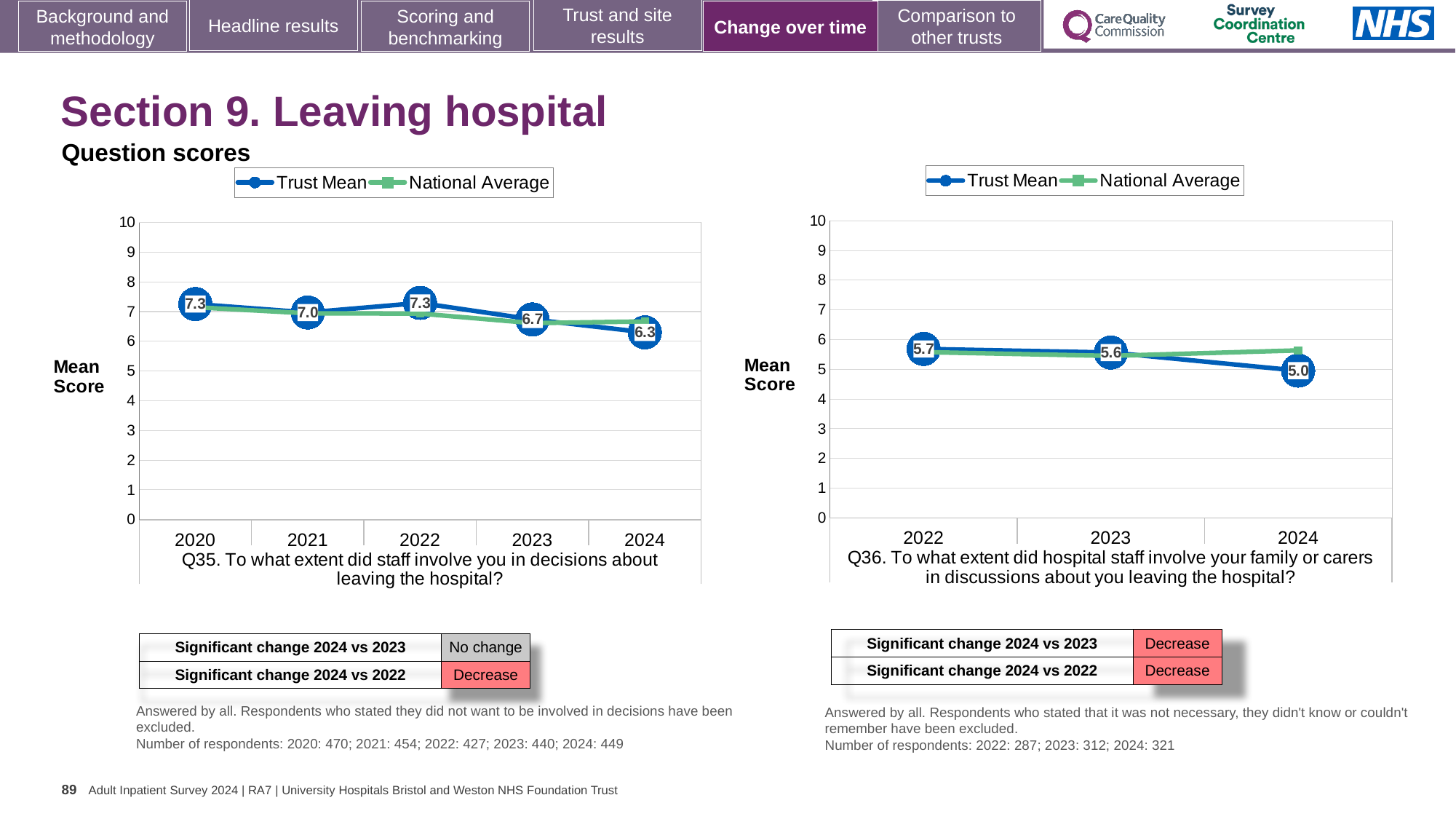
How many years are plotted on the x axis of the Q35 chart (left)? 5 In the Q36 chart (right), which year has the highest Trust Mean score? 2022 In the Q36 chart (right), what is the Trust Mean score for 2024? 5.0 In the Q35 chart (left), is the Trust Mean score for 2023 higher or lower than for 2024? higher In the Q35 chart (left), what is the Trust Mean score for 2024? 6.3 In the Q36 chart (right), what is the difference between the Trust Mean scores for 2022 and 2024? 0.7 In the Q35 chart (left), what is the Trust Mean score for 2021? 7.0 In the Q35 chart (left), which year has the lowest Trust Mean score? 2024 In the Q36 chart (right), is the National Average for 2024 greater or less than 5? greater In the Q35 chart (left), what is the difference between the Trust Mean scores for 2022 and 2024? 1.0 What type of chart is used for the Q36 chart (right)? line chart In the Q36 chart (right), what is the Trust Mean score for 2022? 5.7